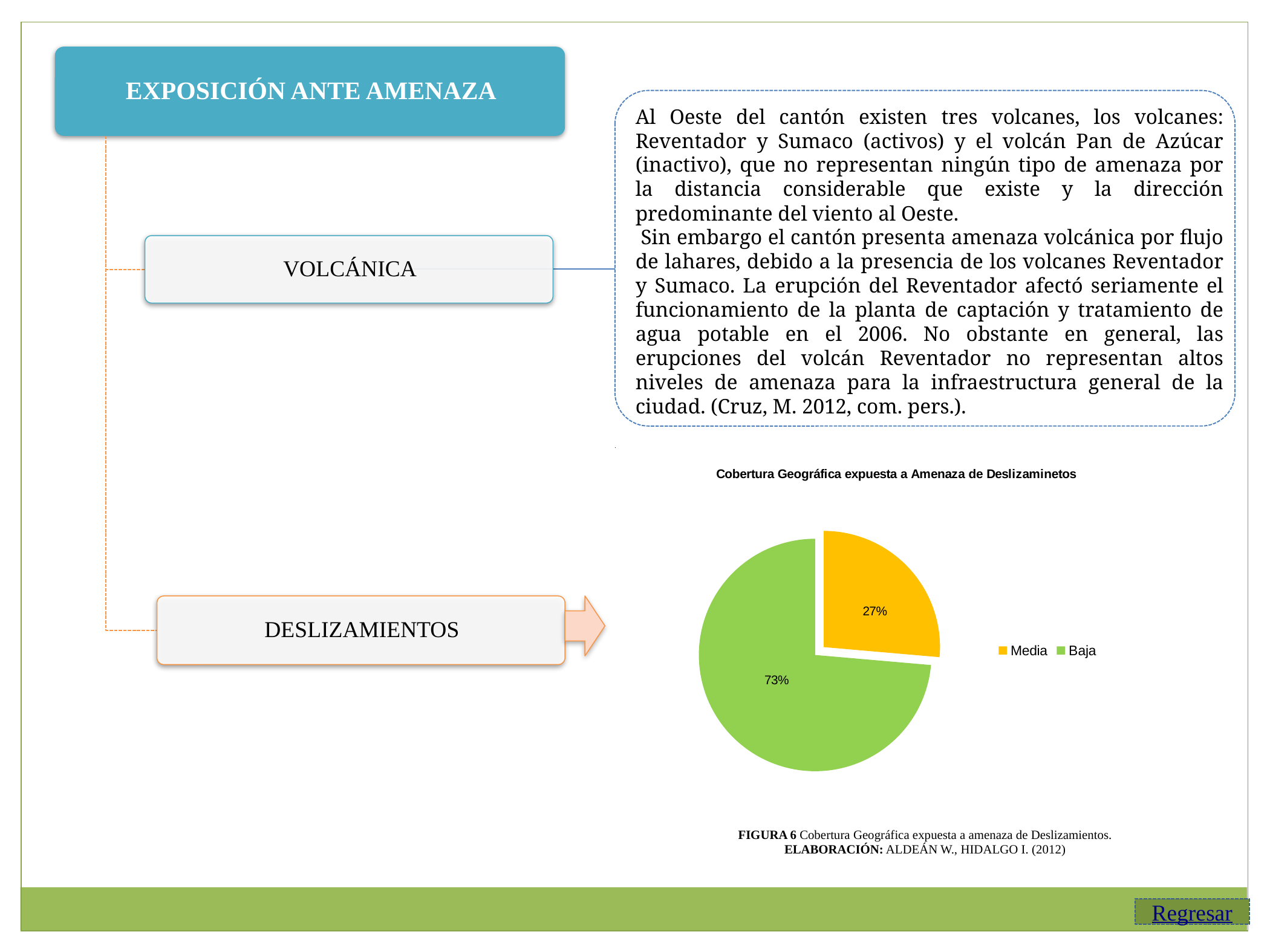
Which category has the largest slice of the pie? Baja What kind of chart is shown on the slide? pie chart How many slices does the pie chart have? 2 Is the value for Baja greater or less than 50%? greater What share of the pie does the Media slice represent? 27% Which category has the smallest slice of the pie? Media What is the difference in percentage points between the Baja and Media slices? 46 What is the title of the chart? Cobertura Geográfica expuesta a Amenaza de Deslizaminetos What share of the pie does the Baja slice represent? 73% What colour is the Media slice? yellow/orange Which slice is larger, Media or Baja? Baja How many entries does the legend list? 2